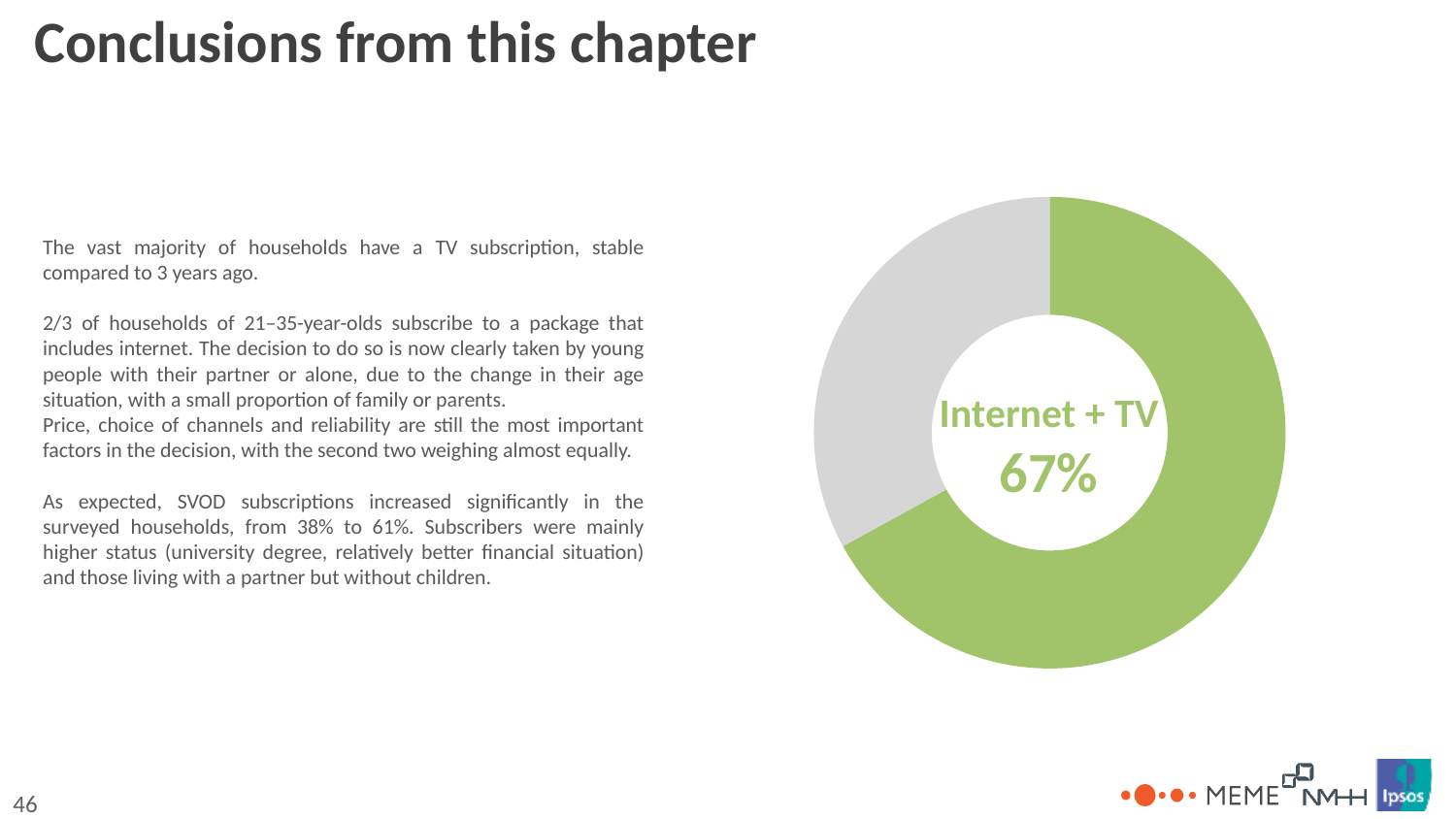
Which slice of the pie chart is the largest? Internet + TV What label is printed in the centre of the donut chart? Internet + TV 67% What colour is the Internet + TV slice of the chart? Green How many slices does the pie chart have? 2 Is the value for Internet + TV greater or less than 50%? greater Which slice is larger in the pie chart, the green one or the grey one? The green one What share of the pie does the Internet + TV slice represent? 67% What percentage is shown for Internet + TV in the chart? 67% What kind of chart is shown on the slide? Pie chart (donut)